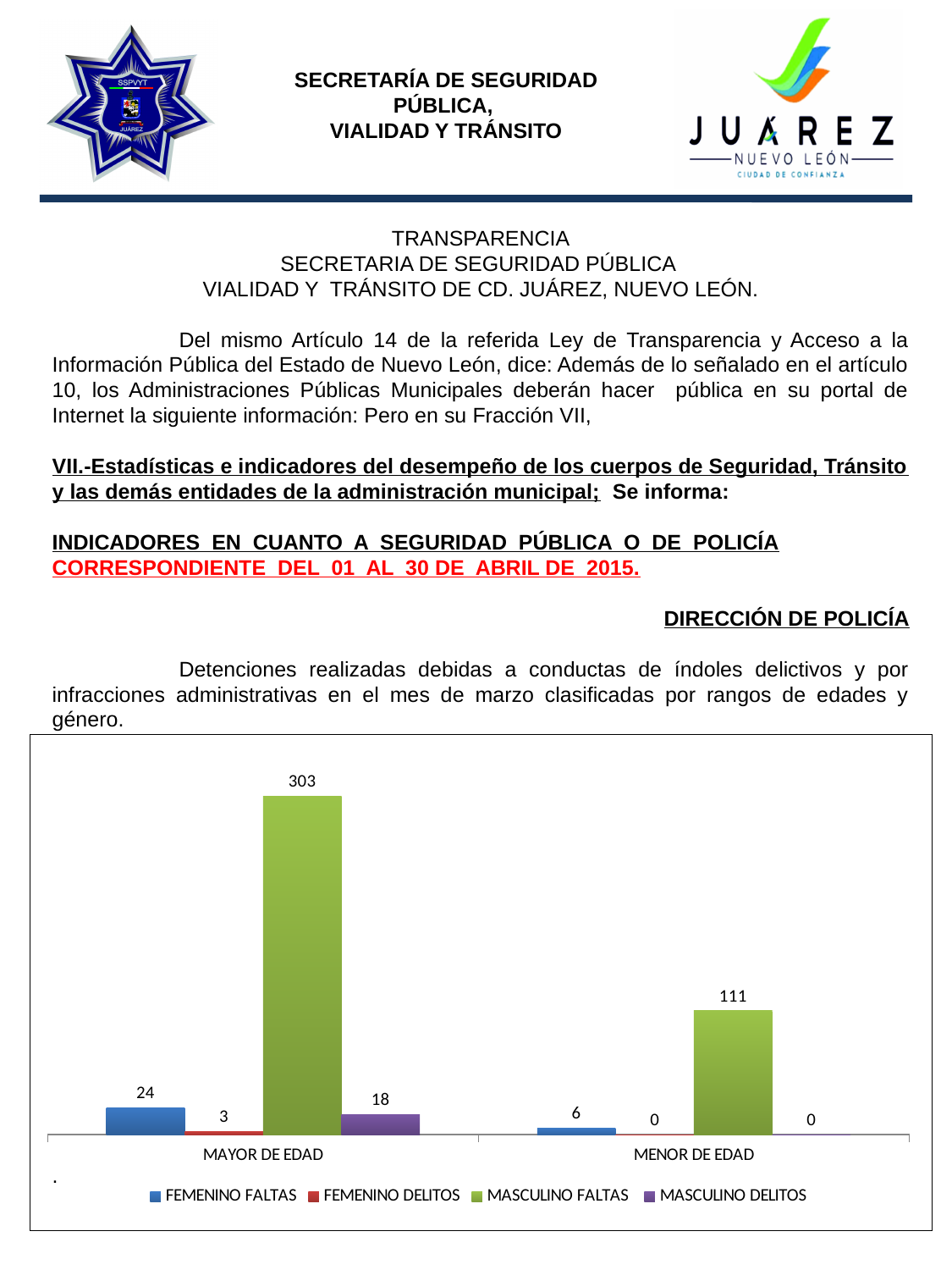
Which series has the lowest value in the MAYOR DE EDAD category? FEMENINO DELITOS What is the value for MASCULINO FALTAS in the MAYOR DE EDAD category? 303 What is the value for FEMENINO DELITOS in the MENOR DE EDAD category? 0 What kind of chart is shown on the slide? Bar chart What is the value for FEMENINO FALTAS in the MENOR DE EDAD category? 6 Which series has the highest value in the MAYOR DE EDAD category? MASCULINO FALTAS What is the difference between MASCULINO FALTAS for MAYOR DE EDAD and MASCULINO FALTAS for MENOR DE EDAD? 192 How many categories are shown on the x axis of the chart? 2 Which is larger: FEMENINO FALTAS for MAYOR DE EDAD or MASCULINO DELITOS for MAYOR DE EDAD? FEMENINO FALTAS for MAYOR DE EDAD How many series does the legend list? 4 What colour are the MASCULINO FALTAS bars? Green What is the value for MASCULINO DELITOS in the MAYOR DE EDAD category? 18